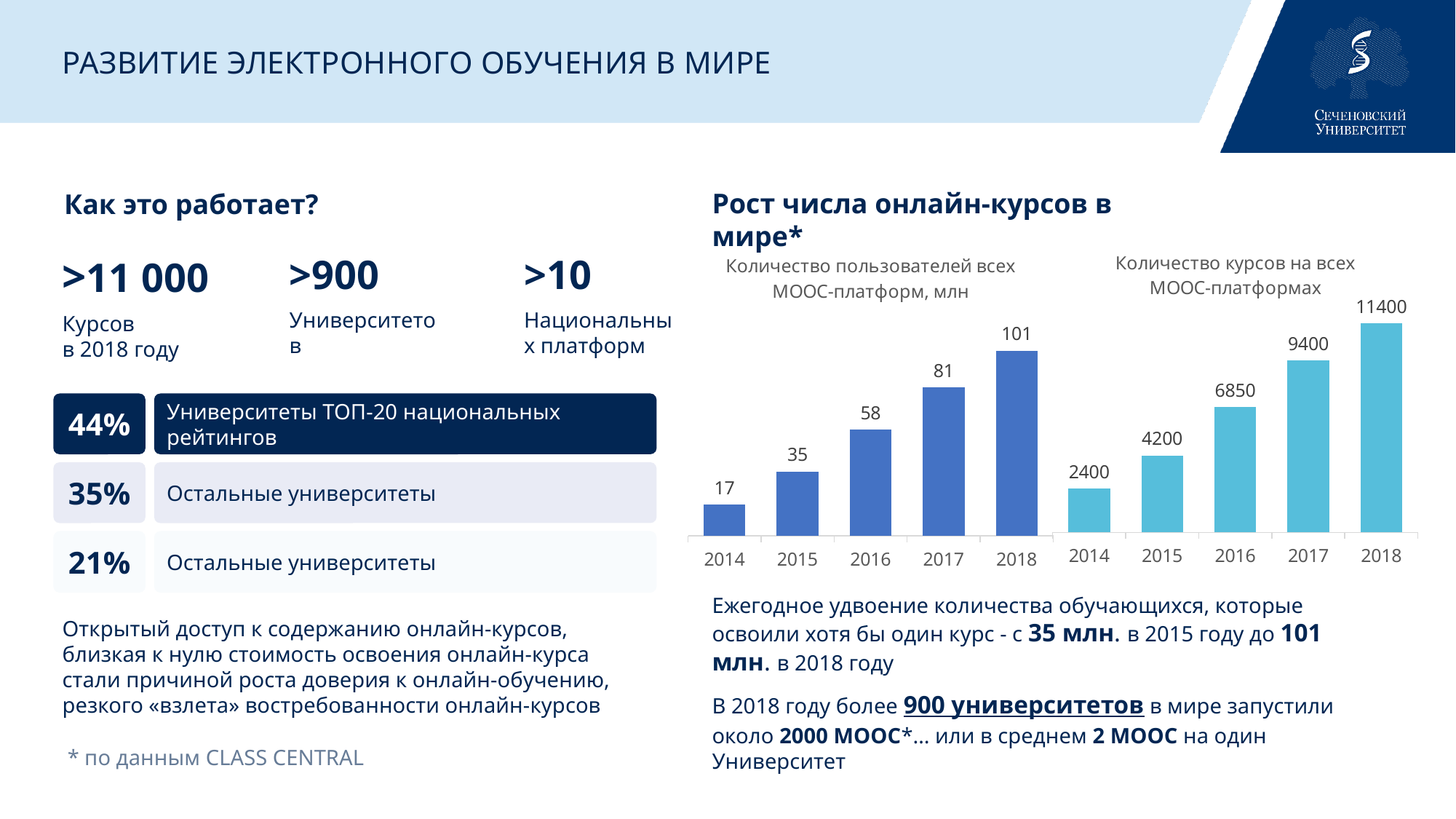
In the chart 'Количество пользователей всех MOOC-платформ, млн', which year has the highest value? 2018 In the chart 'Количество курсов на всех MOOC-платформах', which year has the lowest value? 2014 What colour are the bars in the chart 'Количество курсов на всех MOOC-платформах'? light blue In the chart 'Количество пользователей всех MOOC-платформ, млн', do the values rise or fall from 2014 to 2018? rise In the chart 'Количество пользователей всех MOOC-платформ, млн', what is the difference between the values for 2018 and 2015? 66 In the chart 'Количество курсов на всех MOOC-платформах', which is larger, the value for 2015 or the value for 2016? 2016 What kind of chart is 'Количество курсов на всех MOOC-платформах'? bar chart In the chart 'Количество пользователей всех MOOC-платформ, млн', what is the value for 2014? 17 In the chart 'Количество пользователей всех MOOC-платформ, млн', what is the value for 2016? 58 In the chart 'Количество курсов на всех MOOC-платформах', what is the value for 2017? 9400 In the chart 'Количество курсов на всех MOOC-платформах', what is the difference between the values for 2018 and 2014? 9000 How many years are shown on the x axis of the chart 'Количество пользователей всех MOOC-платформ, млн'? 5